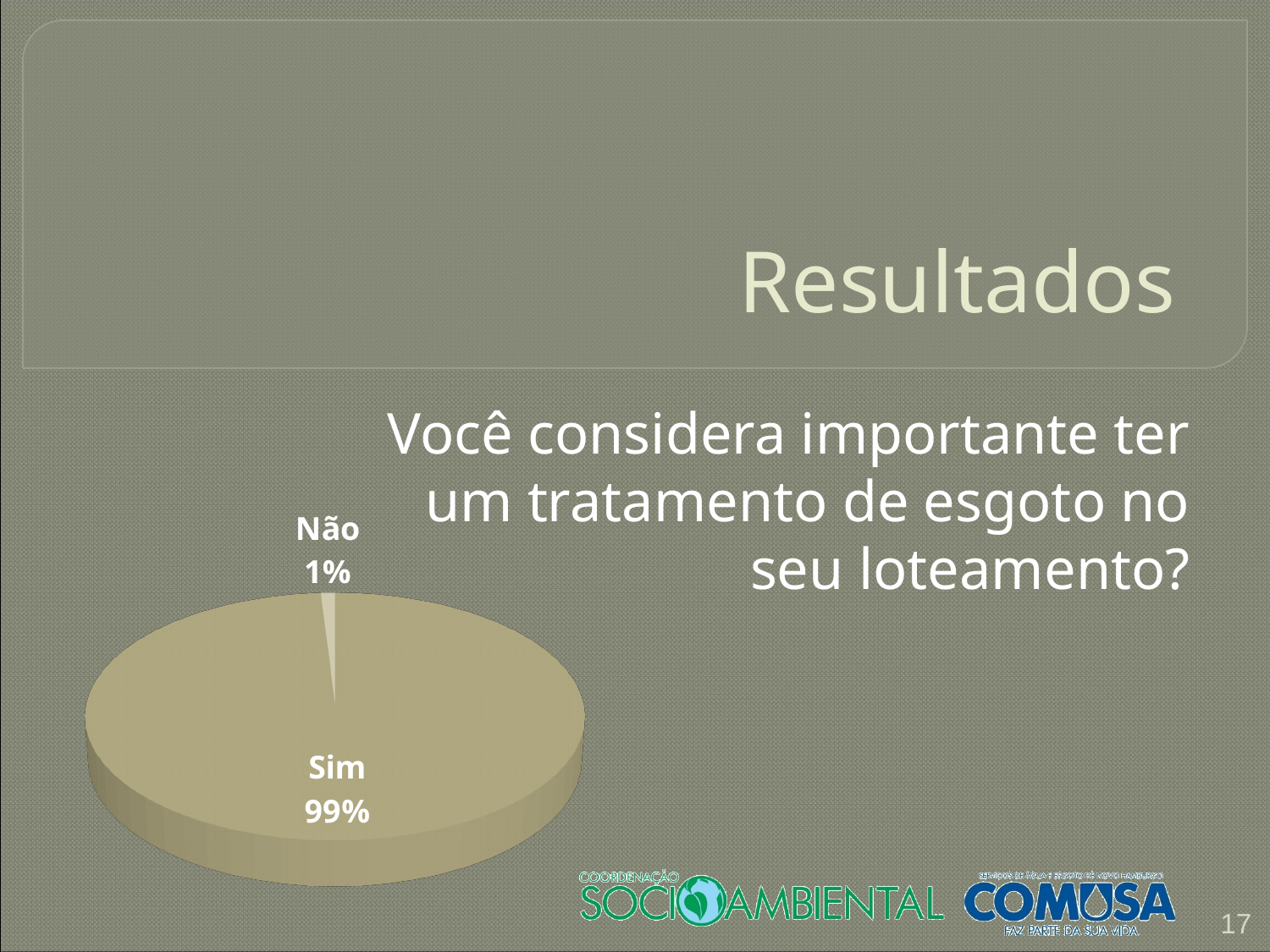
What is the difference in percentage points between the "Sim" and "Não" slices? 98 What share of the pie does the "Sim" slice represent? 99% Which slice of the pie is the largest? Sim How many slices does the pie chart have? 2 Which slice of the pie is the smallest? Não What share of the pie does the "Não" slice represent? 1% Which is larger, the "Sim" slice or the "Não" slice? Sim What question does the pie chart present the results for? Você considera importante ter um tratamento de esgoto no seu loteamento? What kind of chart is shown on the slide? pie chart What is the title shown at the top of the slide? Resultados